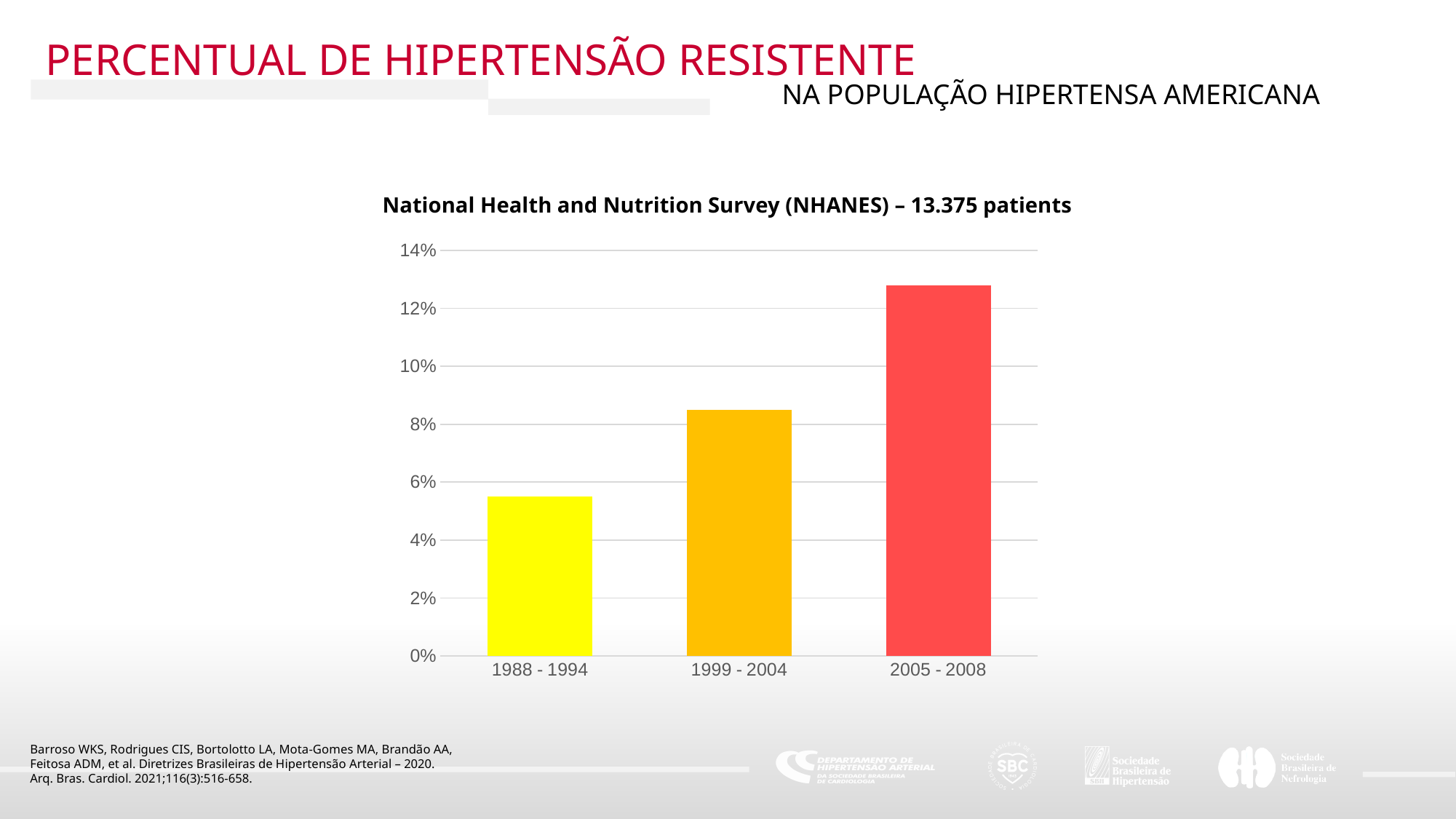
Which period has the lowest percentage of resistant hypertension in the chart? 1988 - 1994 Is the value for 2005 - 2008 greater or less than 12%? greater Is the value for 1999 - 2004 greater or less than 8%? greater How many periods (categories) are shown on the x axis of the chart? 3 What is the title printed above the chart? National Health and Nutrition Survey (NHANES) – 13.375 patients Which is larger, the value for 1999 - 2004 or the value for 1988 - 1994? 1999 - 2004 What kind of chart is shown on the slide? bar chart Is the value for 2005 - 2008 greater or less than 14%? less Which period has the highest percentage of resistant hypertension in the chart? 2005 - 2008 Do the values rise or fall from 1988 - 1994 to 2005 - 2008? rise